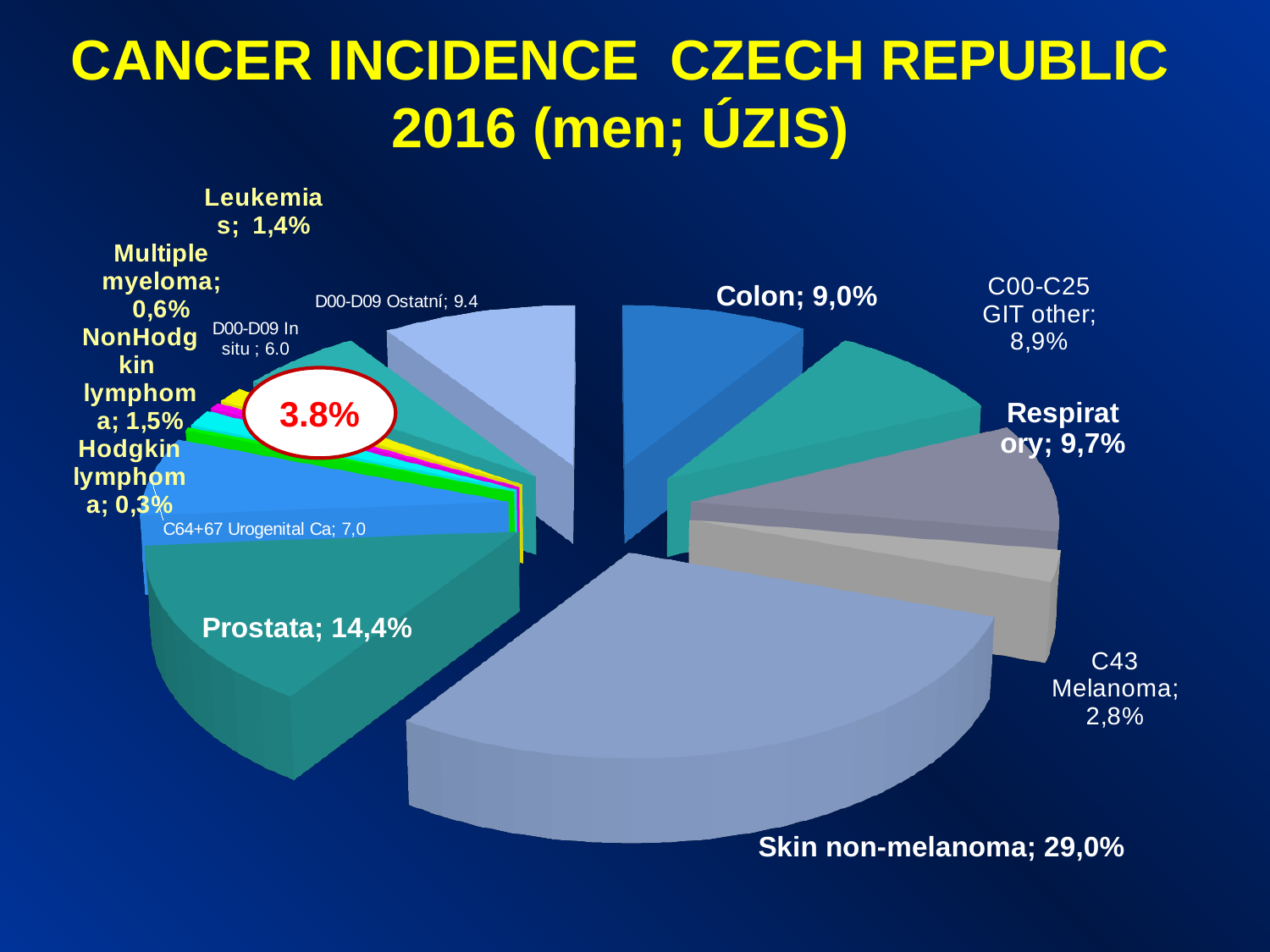
Which category has the largest slice of the pie? Skin non-melanoma Which is larger, the share for Colon or the share for C00-C25 GIT other? Colon What value is printed inside the red oval on the chart? 3.8% What is the value shown for Prostata? 14,4% What value is shown for C64+67 Urogenital Ca? 7,0 What is the value shown for C43 Melanoma? 2,8% Which labelled category has the smallest share? Hodgkin lymphoma What share does Skin non-melanoma have in the pie chart? 29,0% What is the difference between the Respiratory share and the Colon share? 0,7% What kind of chart is shown on the slide? pie chart How much larger is the Skin non-melanoma share than the Prostata share? 14,6% What share is shown for Leukemias? 1,4%